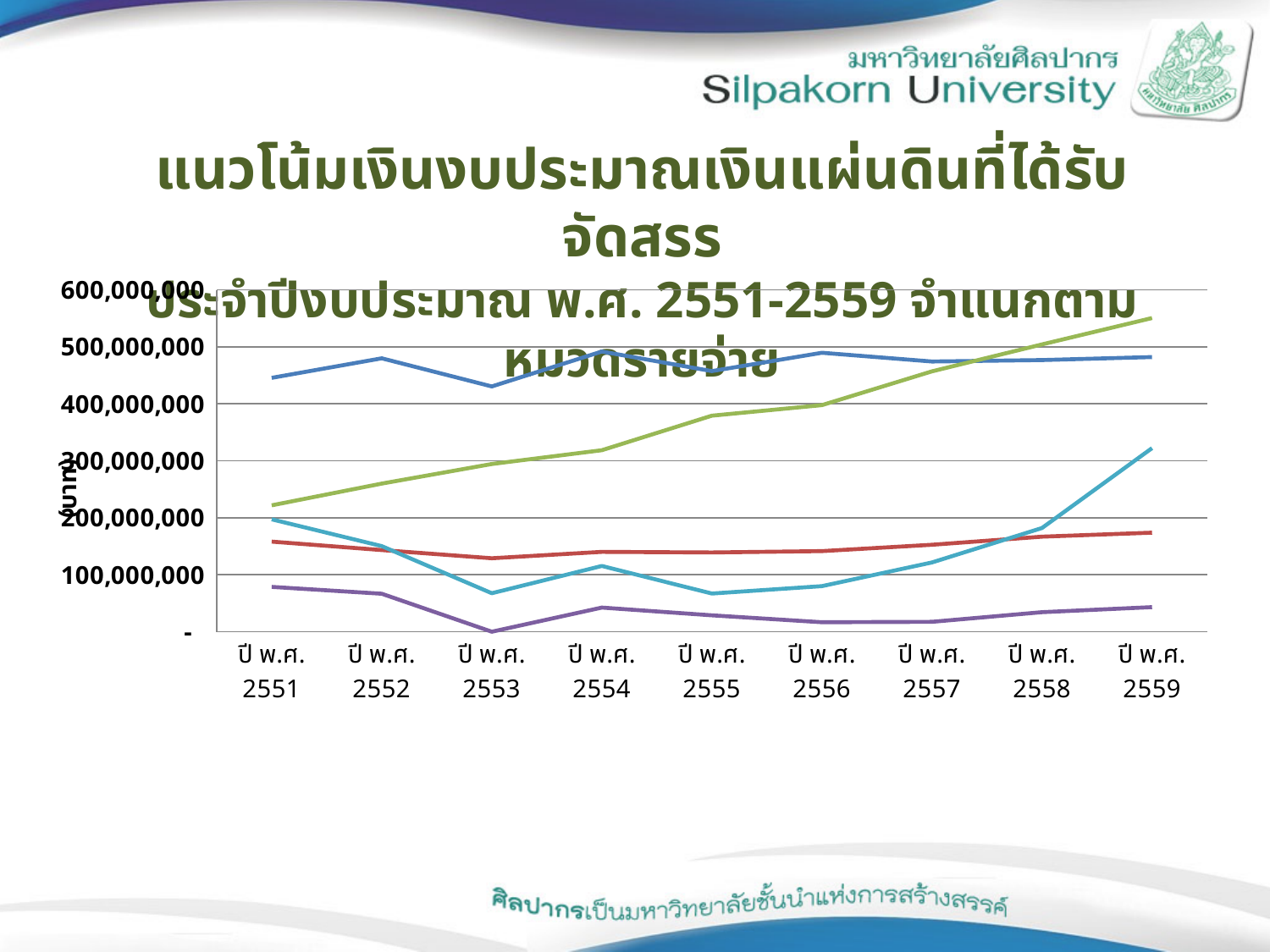
At ปี พ.ศ. 2559, which line has the higher value: the green line or the dark blue line? the green line Is the value of the light blue line for ปี พ.ศ. 2559 greater or less than 300,000,000? greater How many lines are plotted on the chart? 5 At ปี พ.ศ. 2551, which line has the higher value: the dark blue line or the green line? the dark blue line Does the green line rise or fall overall from ปี พ.ศ. 2551 to ปี พ.ศ. 2559? rise Is the value of the dark blue line for ปี พ.ศ. 2553 greater or less than 400,000,000? greater In which year does the green line reach its highest value? ปี พ.ศ. 2559 Is the value of the red line for ปี พ.ศ. 2551 greater or less than 200,000,000? less How many years (categories) are shown along the x axis of the chart? 9 What kind of chart is shown on the slide? line chart In which year does the purple line reach its lowest value? ปี พ.ศ. 2553